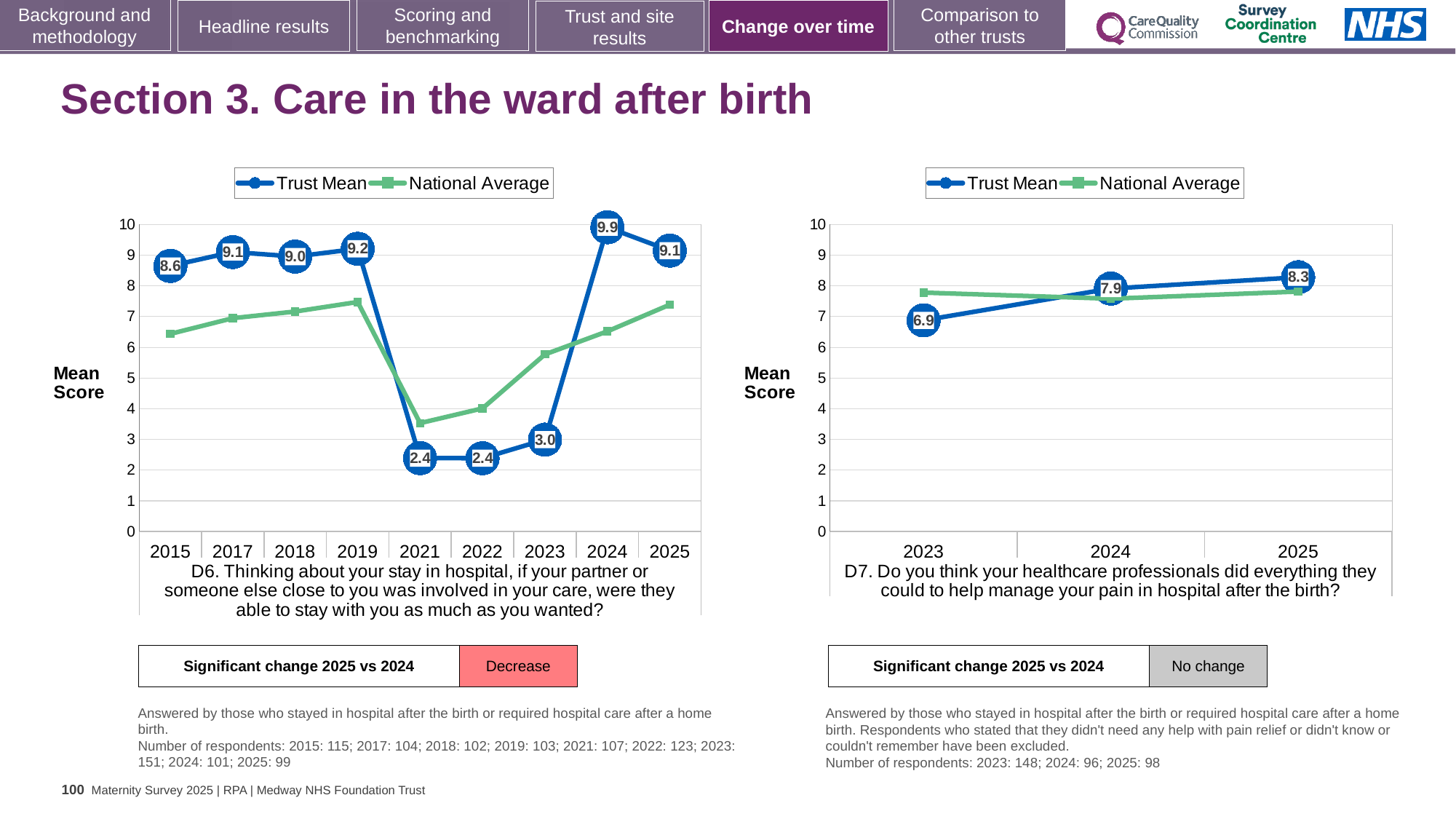
In the D6 chart on the left, is the National Average for 2021 greater or less than 4? less How many series does the legend of the D7 chart on the right list? 2 In the D6 chart on the left, what is the Trust Mean for 2021? 2.4 In the D6 chart on the left, which year has the highest Trust Mean? 2024 In the D6 chart on the left, what is the Trust Mean for 2024? 9.9 In the D7 chart on the right, which year has the lowest Trust Mean? 2023 In the D6 chart on the left, what is the difference between the Trust Mean in 2024 and in 2025? 0.8 How many years are shown on the x axis of the D6 chart on the left? 9 In the D7 chart on the right, does the Trust Mean rise or fall from 2023 to 2025? rise In the D7 chart on the right, what is the difference between the Trust Mean in 2025 and in 2023? 1.4 In the D7 chart on the right, what is the Trust Mean for 2023? 6.9 In the D6 chart on the left, is the Trust Mean higher in 2019 or in 2023? 2019